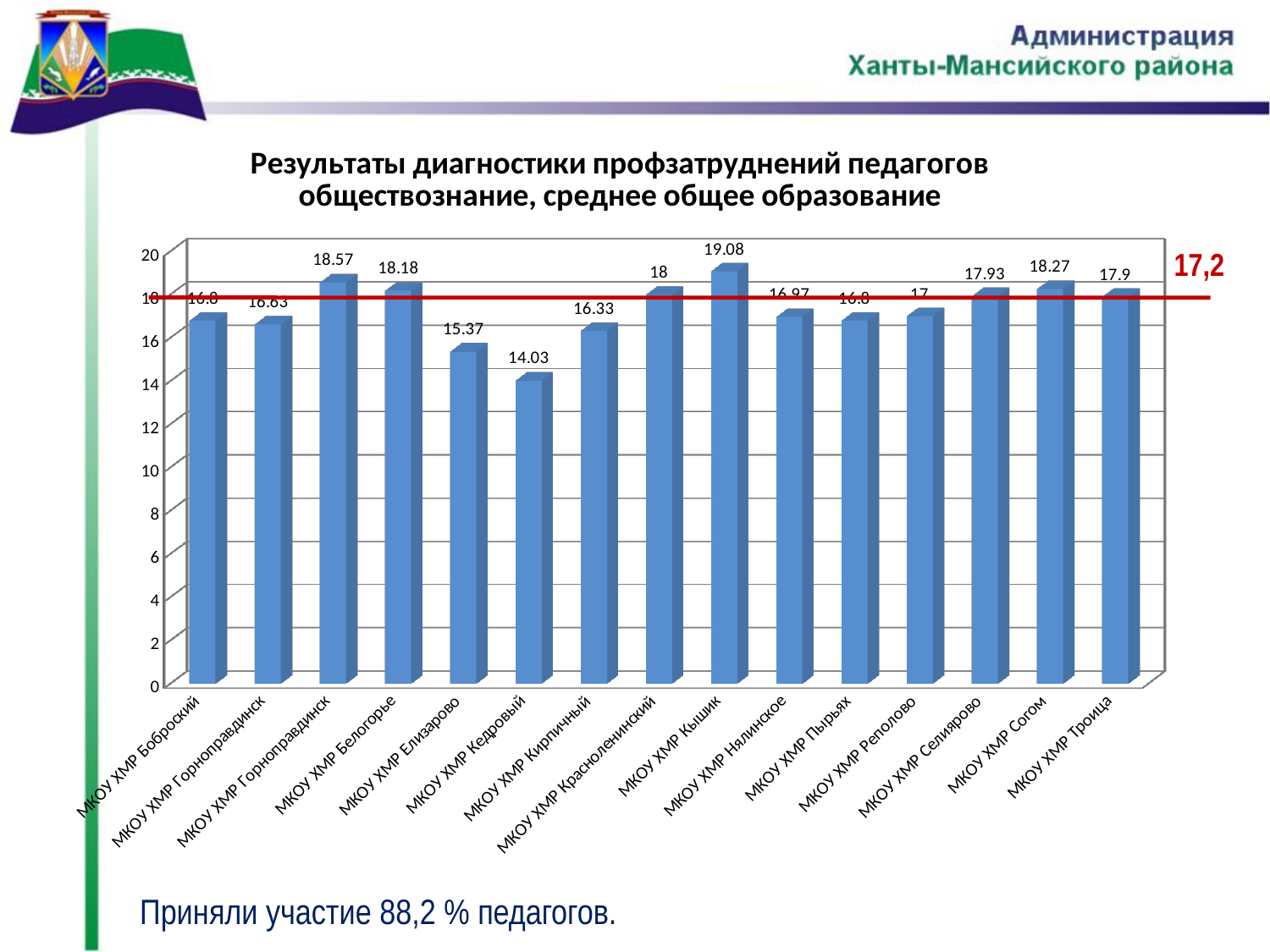
Which school has the lowest value in the chart? МКОУ ХМР Кедровый What is the value for МКОУ ХМР Елизарово? 15.37 What is the value for МКОУ ХМР Кедровый? 14.03 What is the value for МКОУ ХМР Кышик? 19.08 How many schools (categories) are plotted in the chart? 15 What type of chart is shown on the slide? bar chart What value is marked by the red horizontal line on the chart? 17,2 What is the difference between the values for МКОУ ХМР Кышик and МКОУ ХМР Кедровый? 5.05 Is the value for МКОУ ХМР Кирпичный greater or less than 16? greater Which has a larger value, МКОУ ХМР Белогорье or МКОУ ХМР Елизарово? МКОУ ХМР Белогорье Which school has the highest value in the chart? МКОУ ХМР Кышик What is the value for МКОУ ХМР Белогорье? 18.18